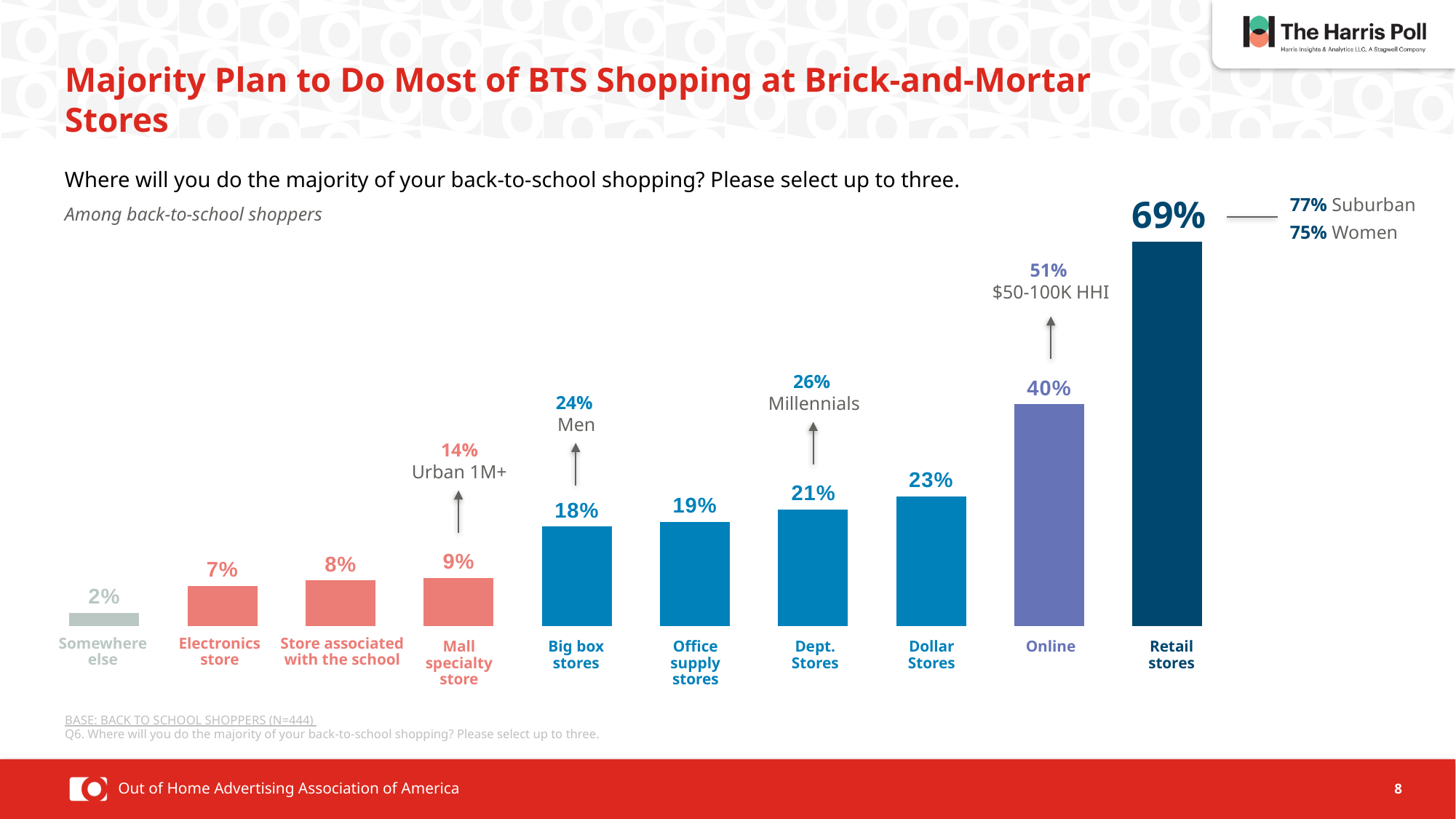
Which category has the lowest value in the chart? Somewhere else Which category has the highest value in the chart? Retail stores What kind of chart is shown on the slide? Bar chart What percentage of Millennials is called out above the Dept. Stores bar? 26% Do the bar values rise or fall moving from left to right along the x axis? Rise How many categories are shown in the chart? 10 Which is larger, the value for Office supply stores or the value for Mall specialty store? Office supply stores What is the difference between the values for Retail stores and Online? 29% What percentage of back-to-school shoppers plan to do the majority of their shopping at retail stores? 69% What is the value shown for Dollar Stores? 23% What is the value shown for Online? 40% What is the difference between the values for Dept. Stores and Big box stores? 3%